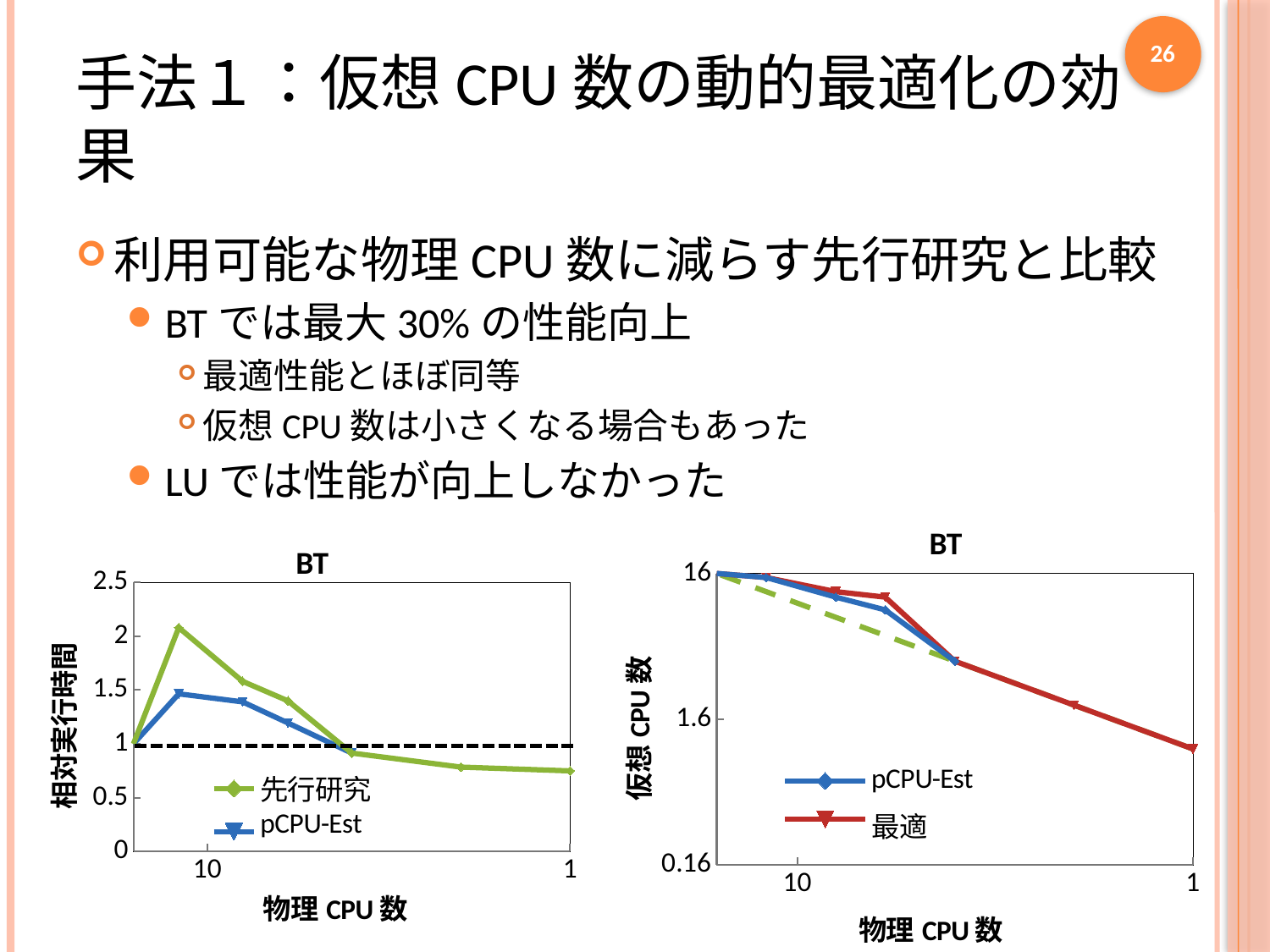
What are the two legend entries of the left chart? 先行研究 and pCPU-Est In the left chart, is the peak value of the 先行研究 line greater or less than 1.5? greater In the right chart, does the 最適 line rise or fall from left to right along the x axis? fall How many series does the legend of the left chart list? 2 In the left chart, is the peak value of the pCPU-Est line greater or less than 1? greater In the left chart, at the peak near 10 physical CPUs, which series is higher, 先行研究 or pCPU-Est? 先行研究 What kind of chart is the left chart titled BT? line chart In the left chart, which series reaches the highest relative execution time? 先行研究 In the right chart, is the value of 最適 at 1 physical CPU greater or less than 1.6? less What is the y-axis title of the right chart? 仮想 CPU 数 How many series does the legend of the right chart list? 2